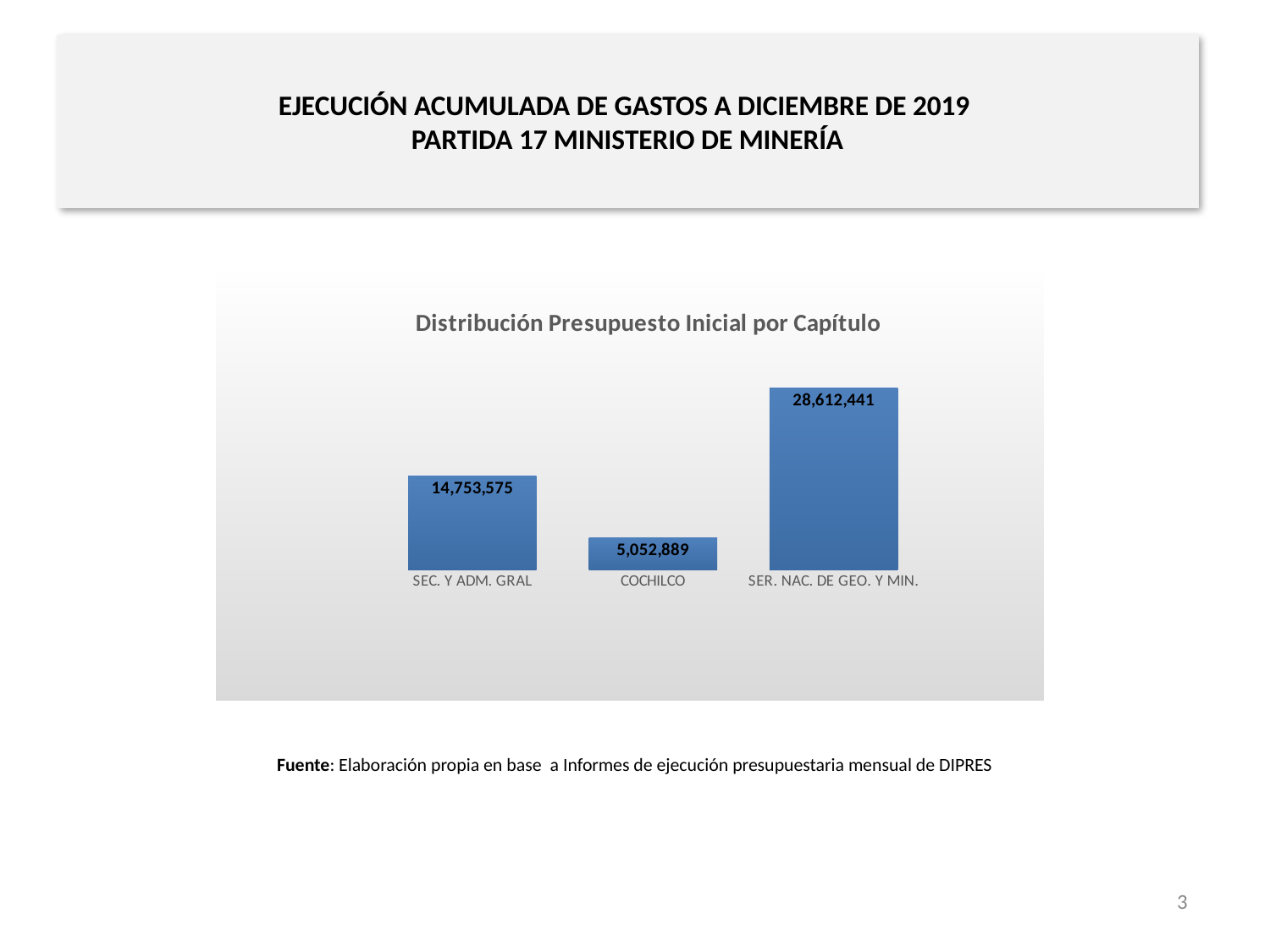
What colour are the bars in the chart? Blue Which category has the highest value? SER. NAC. DE GEO. Y MIN. What is the title of the chart? Distribución Presupuesto Inicial por Capítulo How many categories are shown in the chart? 3 What is the difference between the values for SER. NAC. DE GEO. Y MIN. and SEC. Y ADM. GRAL? 13,858,866 What is the value for SER. NAC. DE GEO. Y MIN.? 28,612,441 What is the difference between the values for SEC. Y ADM. GRAL and COCHILCO? 9,700,686 Which is larger, the value for SEC. Y ADM. GRAL or the value for COCHILCO? SEC. Y ADM. GRAL What kind of chart is shown on the slide? Bar chart Which category has the lowest value? COCHILCO What is the value for COCHILCO? 5,052,889 What is the value for SEC. Y ADM. GRAL? 14,753,575